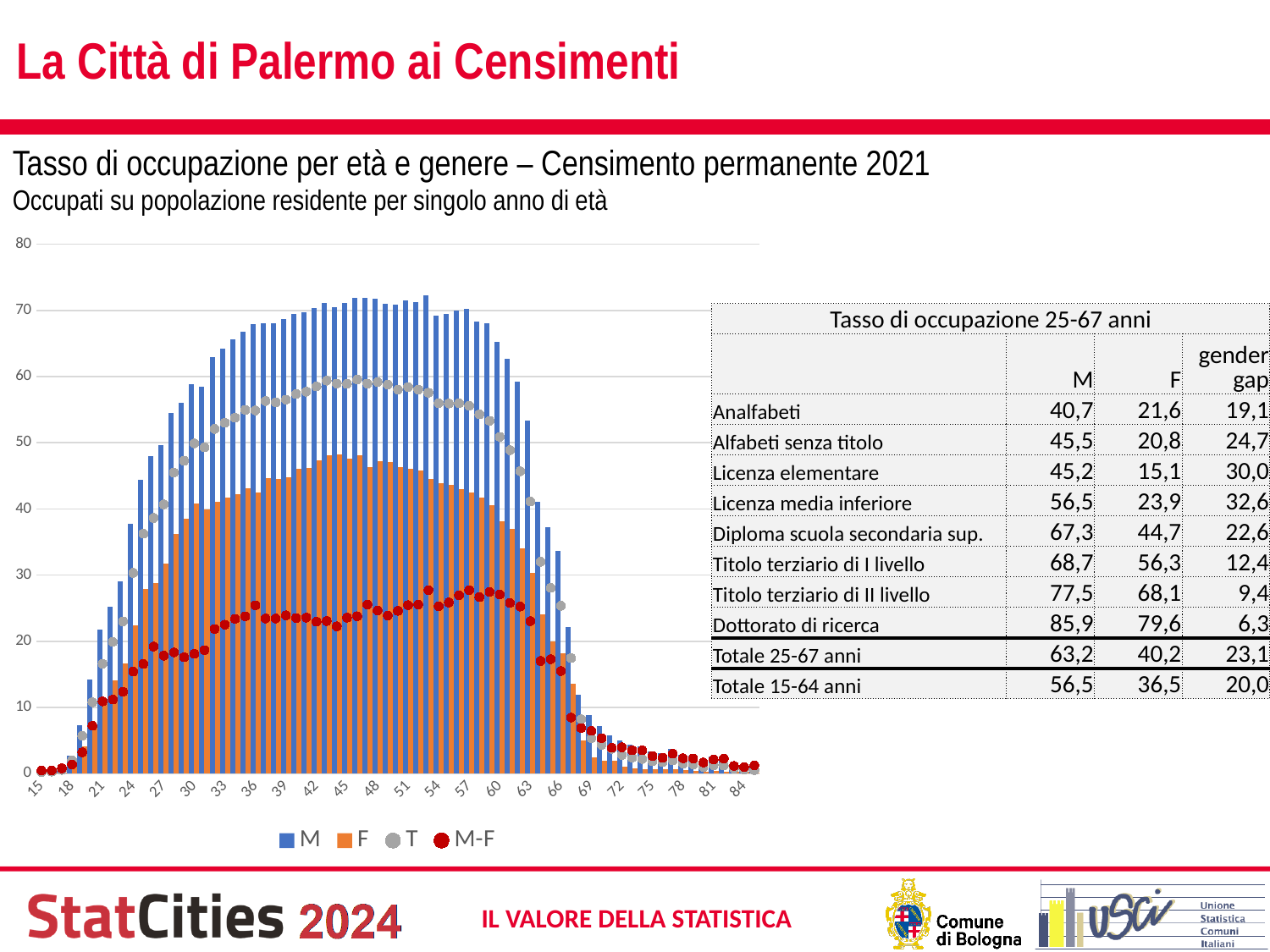
Is the value for F at age 21 greater or less than 20? less Is the value for F at age 45 greater or less than 40? greater Is the value for T at age 45 greater or less than 50? greater Do the values for M rise or fall between age 60 and age 69? fall At age 45, which is larger, the value for M or the value for F? M What kind of chart is shown on the slide? combination bar and line chart Which series has the highest values across the working ages in the chart? M How many series does the chart legend list? 4 What are the four series listed in the chart legend? M, F, T, M-F Which colour are the bars for the F series? orange